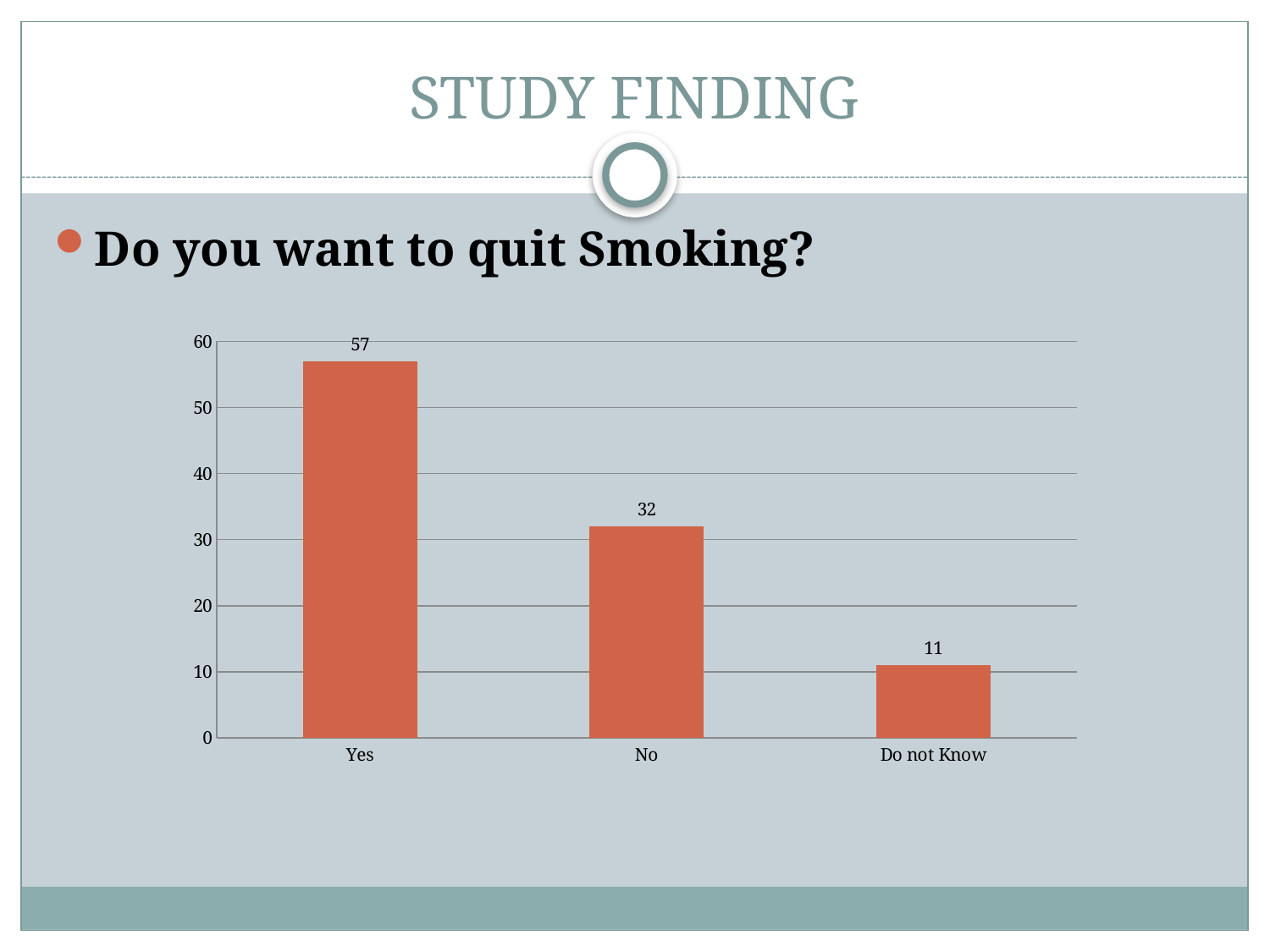
What is the difference between the values for No and Do not Know? 21 Which is larger, the value for No or the value for Do not Know? No Which category has the lowest value? Do not Know What is the value for No? 32 What is the value for Yes? 57 How many categories are shown on the x axis? 3 What is the value for Do not Know? 11 Do the values rise or fall from left to right along the x axis? fall Which category has the highest value? Yes Is the value for Yes greater or less than 50? greater What is the difference between the values for Yes and No? 25 What kind of chart is shown on the slide? bar chart